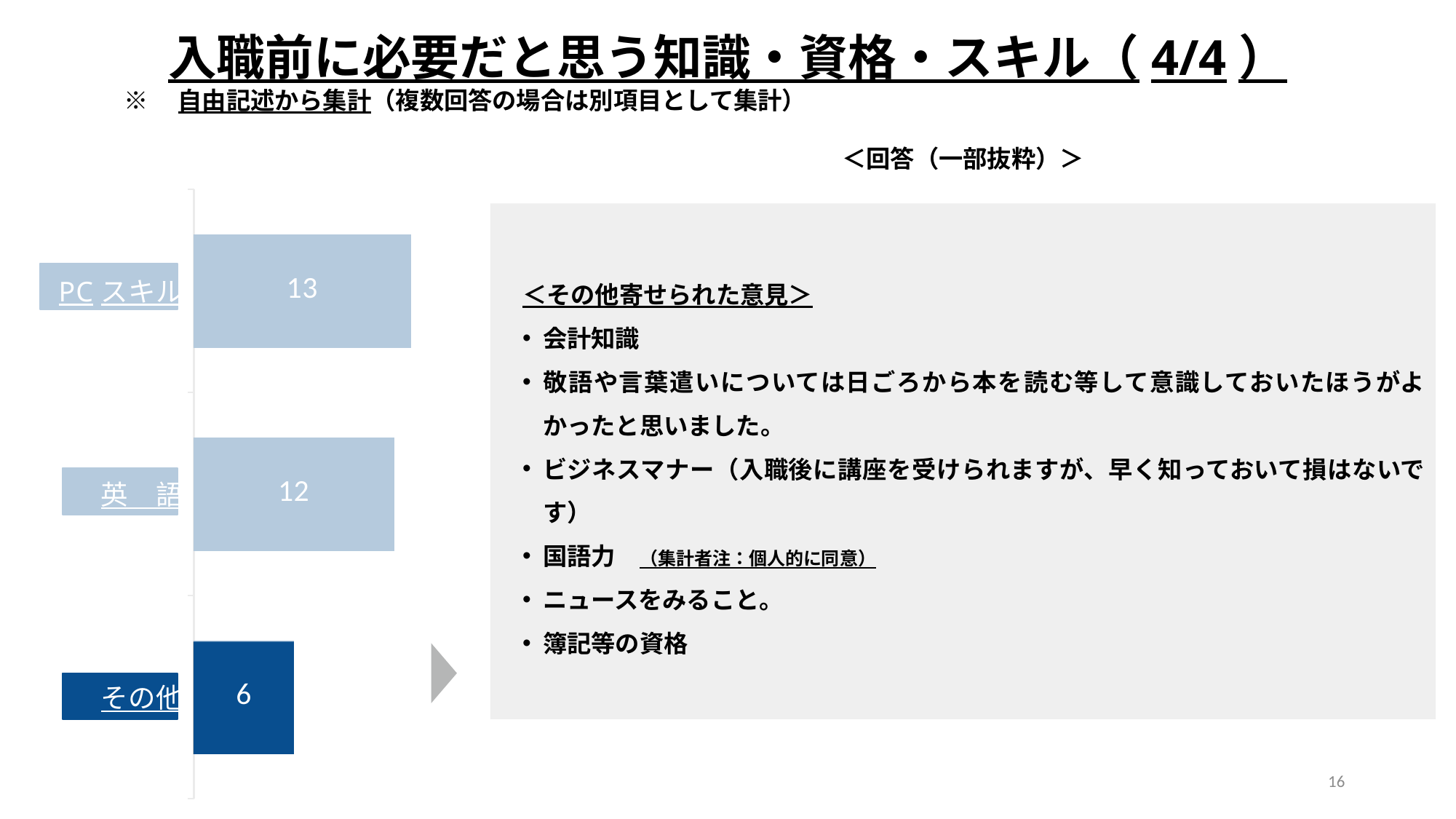
How many categories are shown in the chart? 3 What is the value for PC スキル? 13 What kind of chart is shown on the slide? Bar chart What is the value for その他? 6 Which is larger, the value for 英語 or the value for その他? 英語 What is the value for 英語? 12 Which category has the highest value? PC スキル What is the total of the three values shown in the chart? 31 Which category has the lowest value? その他 Which bar in the chart is coloured dark blue? その他 What is the difference between the values for PC スキル and 英語? 1 What is the difference between the values for PC スキル and その他? 7